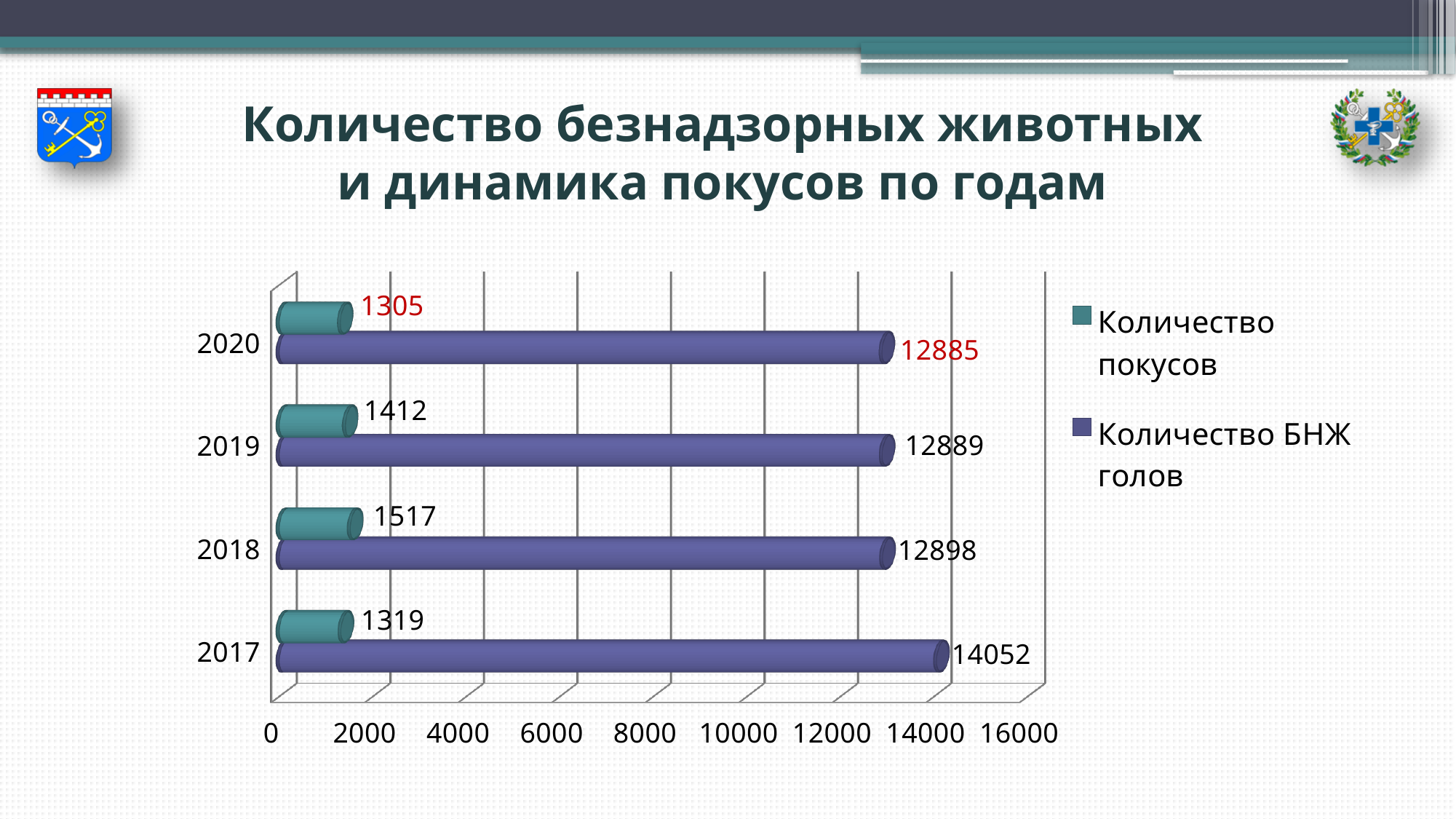
Which is larger: Количество покусов in 2019 or in 2017? 2019 How many years are shown on the chart? 4 What is the value for Количество покусов in 2018? 1517 What is the value for Количество БНЖ голов in 2019? 12889 In which year is Количество покусов highest? 2018 What is the value for Количество покусов in 2020? 1305 How many series does the legend list? 2 In which year is Количество покусов lowest? 2020 Do the values for Количество БНЖ голов rise or fall from 2017 to 2020? fall In which year is Количество БНЖ голов highest? 2017 What is the value for Количество БНЖ голов in 2017? 14052 What is the difference between Количество БНЖ голов in 2017 and in 2020? 1167